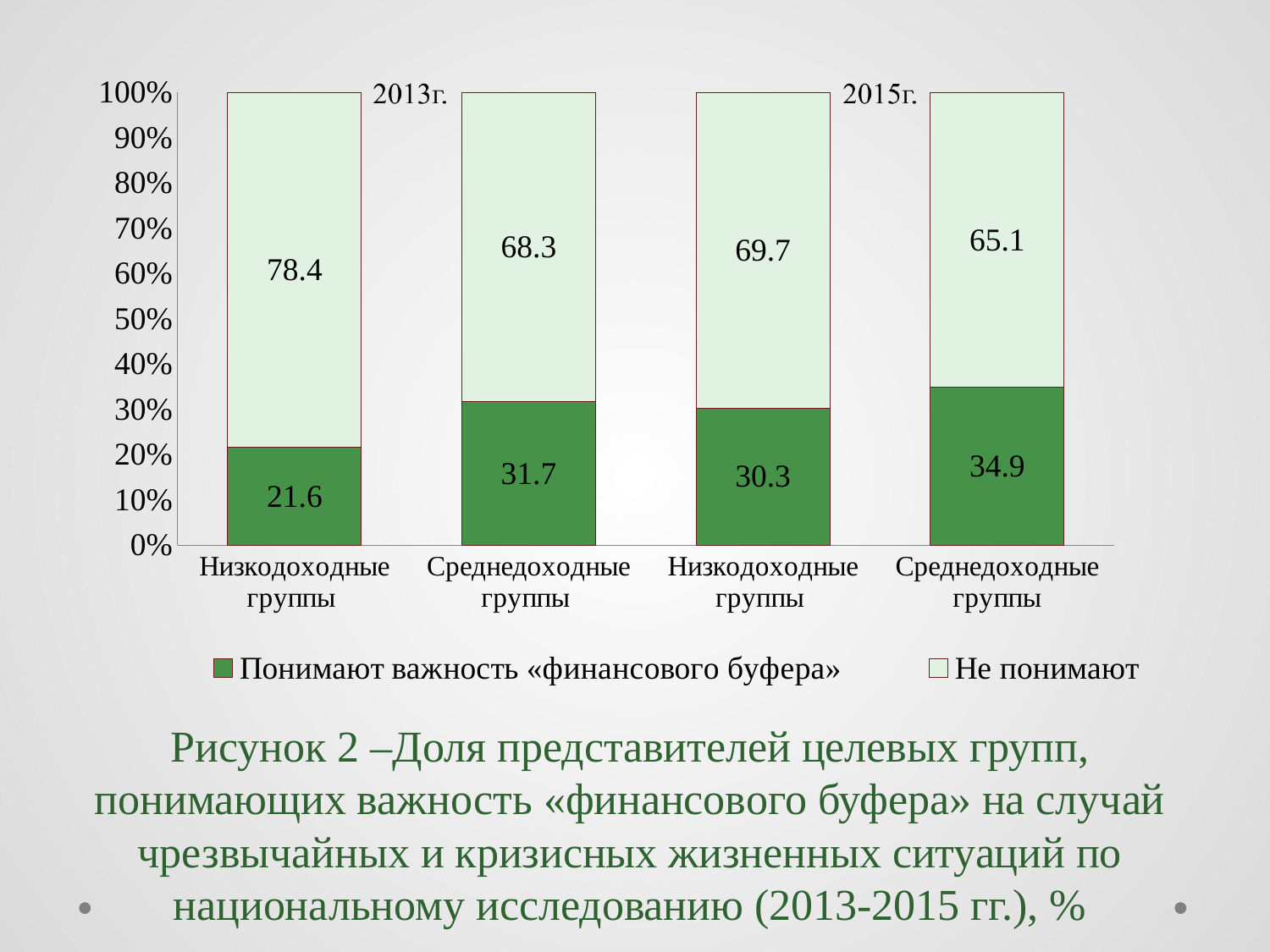
What is the value of «Не понимают» for Среднедоходные группы in 2015г.? 65.1 What is the total of the stacked bar for Среднедоходные группы in 2013г.? 100 What is the value of «Понимают важность «финансового буфера»» for Низкодоходные группы in 2013г.? 21.6 How many bars are plotted in the chart? 4 What is the difference between the «Понимают важность «финансового буфера»» values for Низкодоходные группы in 2015г. and in 2013г.? 8.7 Which bar has the highest value for «Понимают важность «финансового буфера»»? Среднедоходные группы, 2015г. What is the value of «Не понимают» for Низкодоходные группы in 2015г.? 69.7 What type of chart is shown on the slide? Stacked bar chart Which bar has the lowest value for «Понимают важность «финансового буфера»»? Низкодоходные группы, 2013г. How many series does the legend list? 2 Which is larger: the «Не понимают» value for Среднедоходные группы in 2013г. or for Низкодоходные группы in 2015г.? Низкодоходные группы in 2015г. Which legend entry is shown in dark green? Понимают важность «финансового буфера»